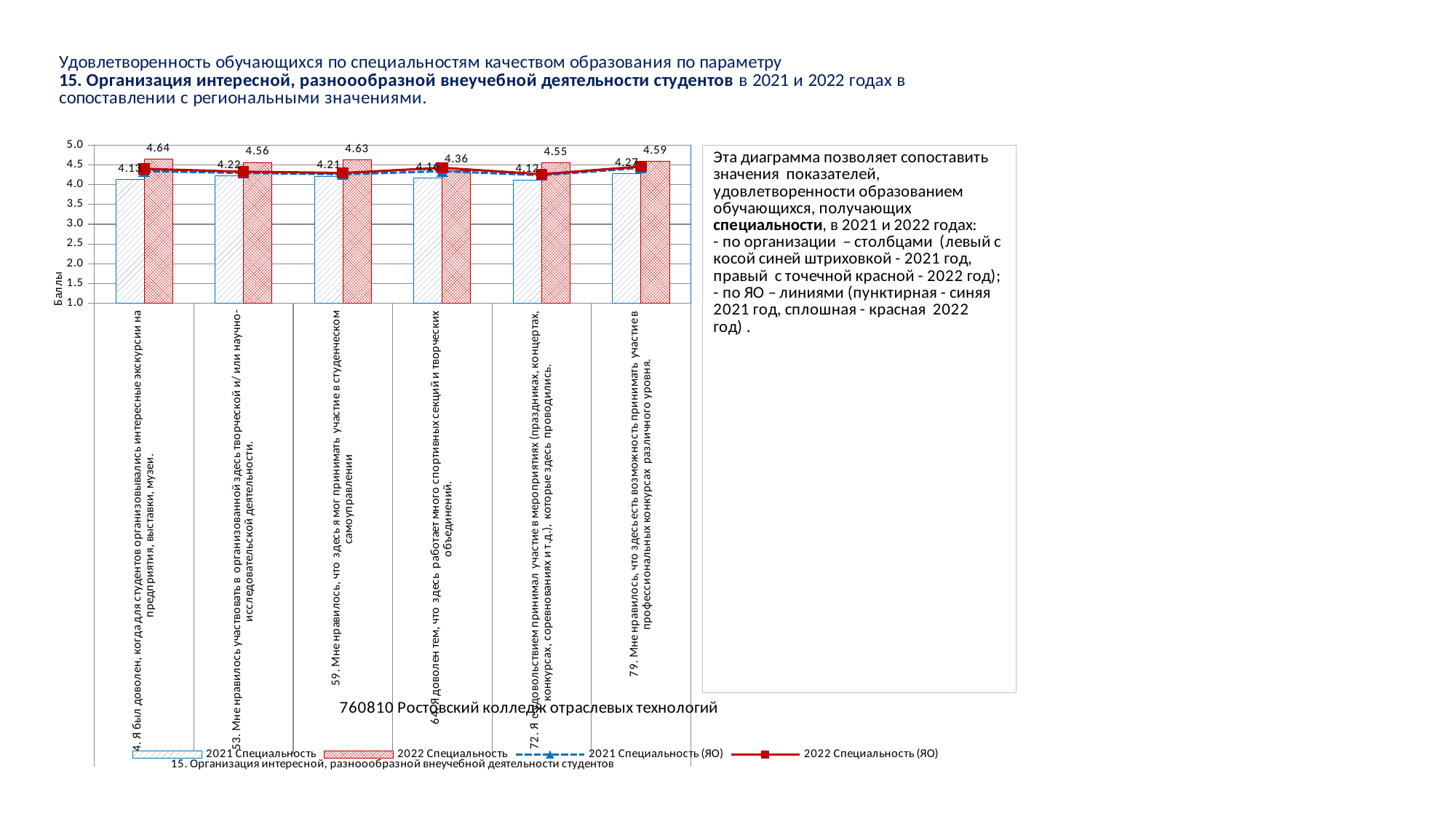
Which category has the lowest 2022 Специальность value? 64. Я доволен тем, что здесь работает много спортивных секций и творческих объединений Is the 2022 Специальность (ЯО) line value for the category "4. Я был доволен, когда для студентов организовывались интересные экскурсии" greater or less than 4.0? greater Which is larger for the category "72. Я с удовольствием принимал участие в мероприятиях": the 2021 Специальность value or the 2022 Специальность value? 2022 Специальность What is the difference between the 2022 and 2021 Специальность values for the category "4. Я был доволен, когда для студентов организовывались интересные экскурсии на предприятия, выставки, музеи"? 0.51 What is the 2022 Специальность value for the category "4. Я был доволен, когда для студентов организовывались интересные экскурсии на предприятия, выставки, музеи"? 4.64 What is the 2021 Специальность value for the category "59. Мне нравилось, что здесь я мог принимать участие в студенческом самоуправлении"? 4.21 How many series does the chart legend list? 4 Which category has the highest 2022 Специальность value? 4. Я был доволен, когда для студентов организовывались интересные экскурсии на предприятия, выставки, музеи How many categories are shown on the x axis of the chart? 6 What kind of chart is shown on the slide? Combined bar and line chart What is the 2021 Специальность value for the category "79. Мне нравилось, что здесь есть возможность принимать участие в профессиональных конкурсах различного уровня"? 4.27 What is the 2022 Специальность value for the category "64. Я доволен тем, что здесь работает много спортивных секций и творческих объединений"? 4.36